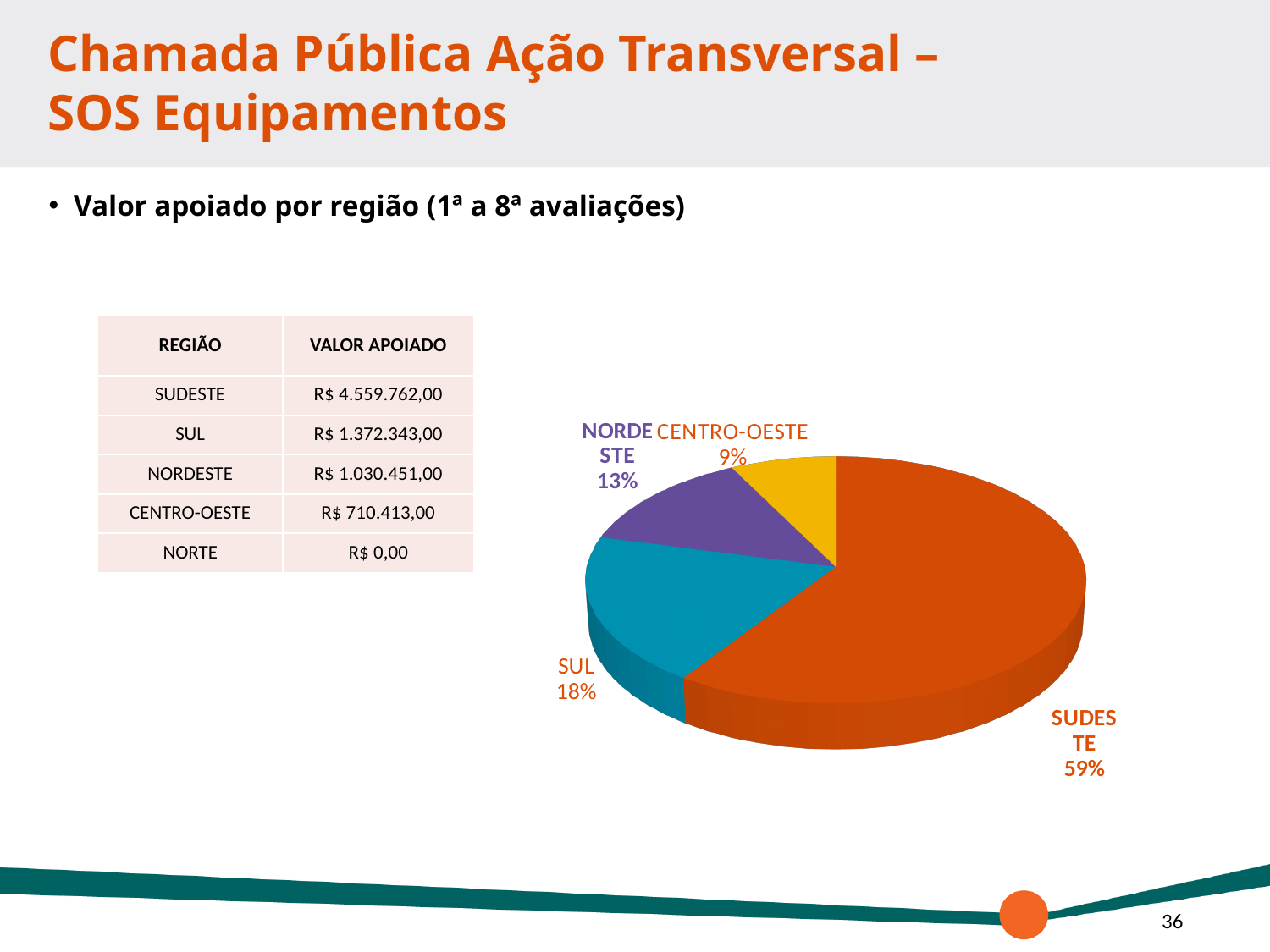
What is the difference in percentage points between the SUDESTE and SUL slices? 41 What share of the pie chart does SUL represent? 18% Which region has the largest slice in the pie chart? SUDESTE What share of the pie chart does CENTRO-OESTE represent? 9% What share of the pie chart does SUDESTE represent? 59% What type of chart is shown on the slide? pie chart Which labelled region has the smallest slice in the pie chart? CENTRO-OESTE Which slice is larger in the pie chart, SUL or NORDESTE? SUL What is the difference in percentage points between the NORDESTE and CENTRO-OESTE slices? 4 What colour is the SUDESTE slice in the pie chart? orange How many labelled slices does the pie chart have? 4